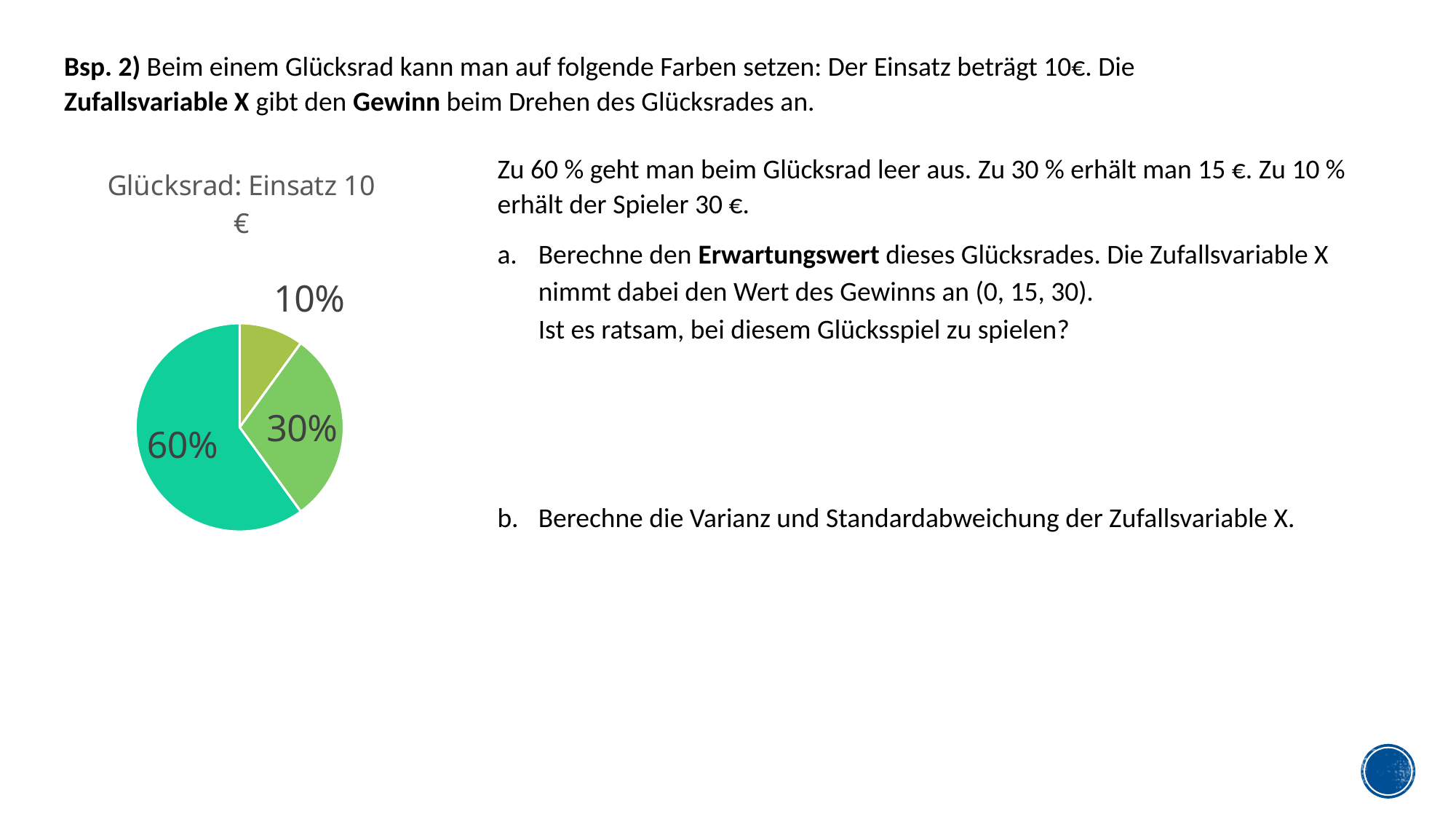
What is the share of the largest slice of the pie chart? 60% Is the share of the teal slice greater or less than 50%? greater Which is larger in the pie chart, the light green slice or the olive-coloured slice? the light green slice How many slices does the pie chart have? 3 What is the title of the pie chart? Glücksrad: Einsatz 10 € What is the share of the smallest slice of the pie chart? 10% What kind of chart is shown on the slide? pie chart What share does the light green slice of the pie chart represent? 30% What share does the teal slice of the pie chart represent? 60% What colour is the largest slice of the pie chart? teal What is the difference in percentage points between the largest and smallest slices of the pie chart? 50 What share does the olive-coloured slice of the pie chart represent? 10%